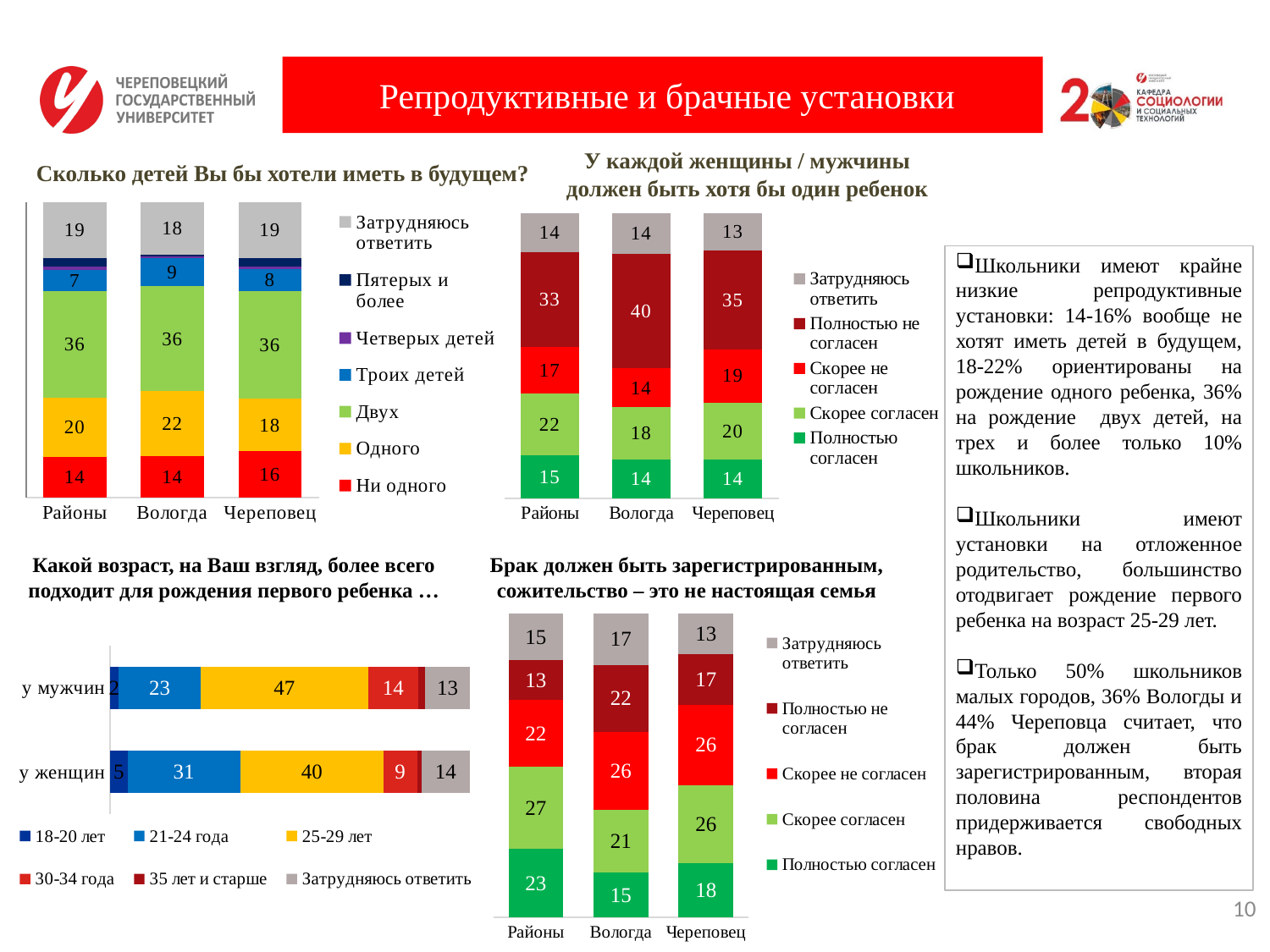
In the chart 'Сколько детей Вы бы хотели иметь в будущем?', what is the value for 'Ни одного' in Череповец? 16 In the chart 'Какой возраст, на Ваш взгляд, более всего подходит для рождения первого ребенка …', what is the value for '25-29 лет' for 'у мужчин'? 47 In the chart 'Сколько детей Вы бы хотели иметь в будущем?', which category has the highest value for 'Одного'? Вологда In the chart 'У каждой женщины / мужчины должен быть хотя бы один ребенок', how many series does the legend list? 5 In the chart 'У каждой женщины / мужчины должен быть хотя бы один ребенок', what is the value for 'Полностью не согласен' in Вологда? 40 In the chart 'Сколько детей Вы бы хотели иметь в будущем?', what is the value for 'Двух' in Вологда? 36 What kind of chart is 'Брак должен быть зарегистрированным, сожительство – это не настоящая семья'? Stacked bar chart In the chart 'Какой возраст, на Ваш взгляд, более всего подходит для рождения первого ребенка …', which is larger: '21-24 года' for 'у мужчин' or for 'у женщин'? у женщин In the chart 'Какой возраст, на Ваш взгляд, более всего подходит для рождения первого ребенка …', how many categories are shown? 2 In the chart 'Брак должен быть зарегистрированным, сожительство – это не настоящая семья', what is the value for 'Полностью согласен' in Районы? 23 In the chart 'Брак должен быть зарегистрированным, сожительство – это не настоящая семья', which category has the lowest value for 'Полностью согласен'? Вологда In the chart 'У каждой женщины / мужчины должен быть хотя бы один ребенок', what is the difference between 'Полностью не согласен' in Вологда and in Районы? 7